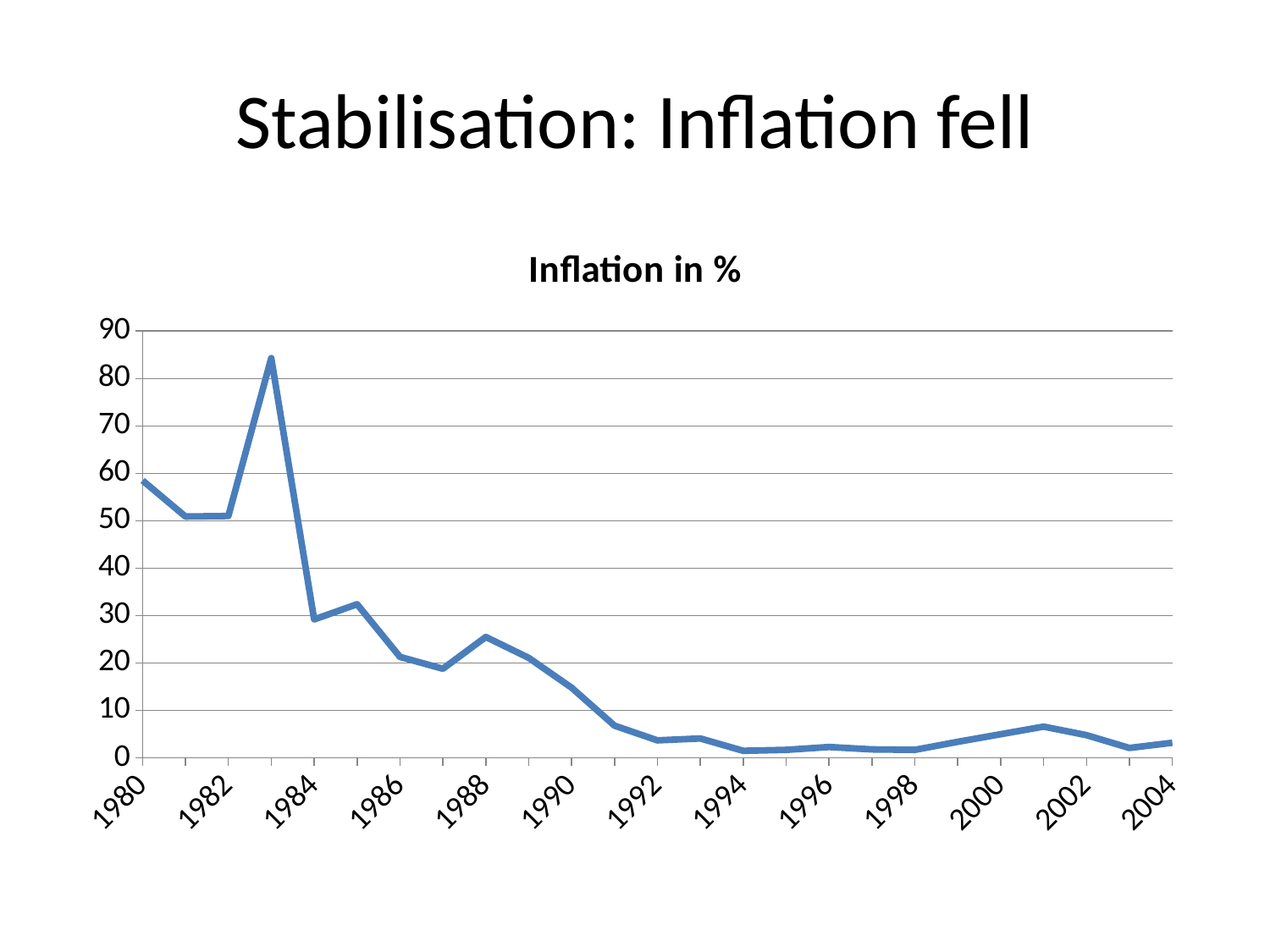
Is the value for 1991 greater or less than 10? less Is the value for 1988 greater or less than 20? greater Is the value for 1980 greater or less than 50? greater What is the title of the chart? Inflation in % How many year labels are shown on the x axis? 13 Which year has the higher inflation, 1980 or 1984? 1980 Which year has the higher inflation, 1994 or 2001? 2001 What kind of chart is shown on the slide? line chart In which year does inflation reach its highest value? 1983 Overall, does inflation rise or fall from 1980 to 2004? fall